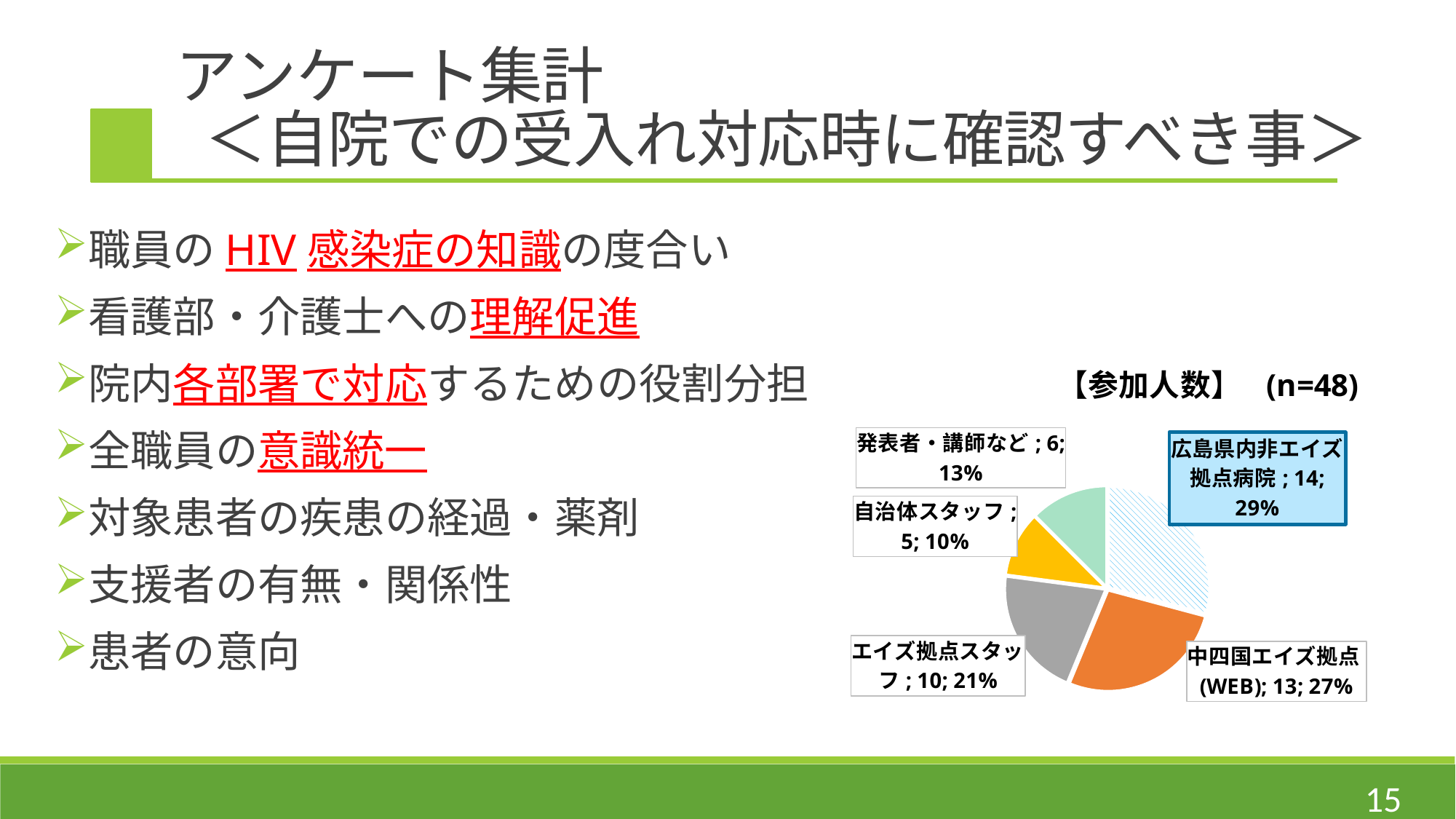
What is the total number of participants (n) shown for the pie chart? 48 What is the value for 広島県内非エイズ拠点病院 in the pie chart? 14 What is the difference between the values for 広島県内非エイズ拠点病院 and エイズ拠点スタッフ? 4 How many slices does the 【参加人数】 pie chart have? 5 What percentage share does 中四国エイズ拠点(WEB) have in the pie chart? 27% What is the value for エイズ拠点スタッフ in the pie chart? 10 Which category has the smallest slice in the pie chart? 自治体スタッフ What percentage share does 自治体スタッフ have in the pie chart? 10% What kind of chart is shown on the slide? pie chart Which is larger in the pie chart, 発表者・講師など or 自治体スタッフ? 発表者・講師など Which category has the largest slice in the pie chart? 広島県内非エイズ拠点病院 What is the title of the pie chart? 【参加人数】 (n=48)